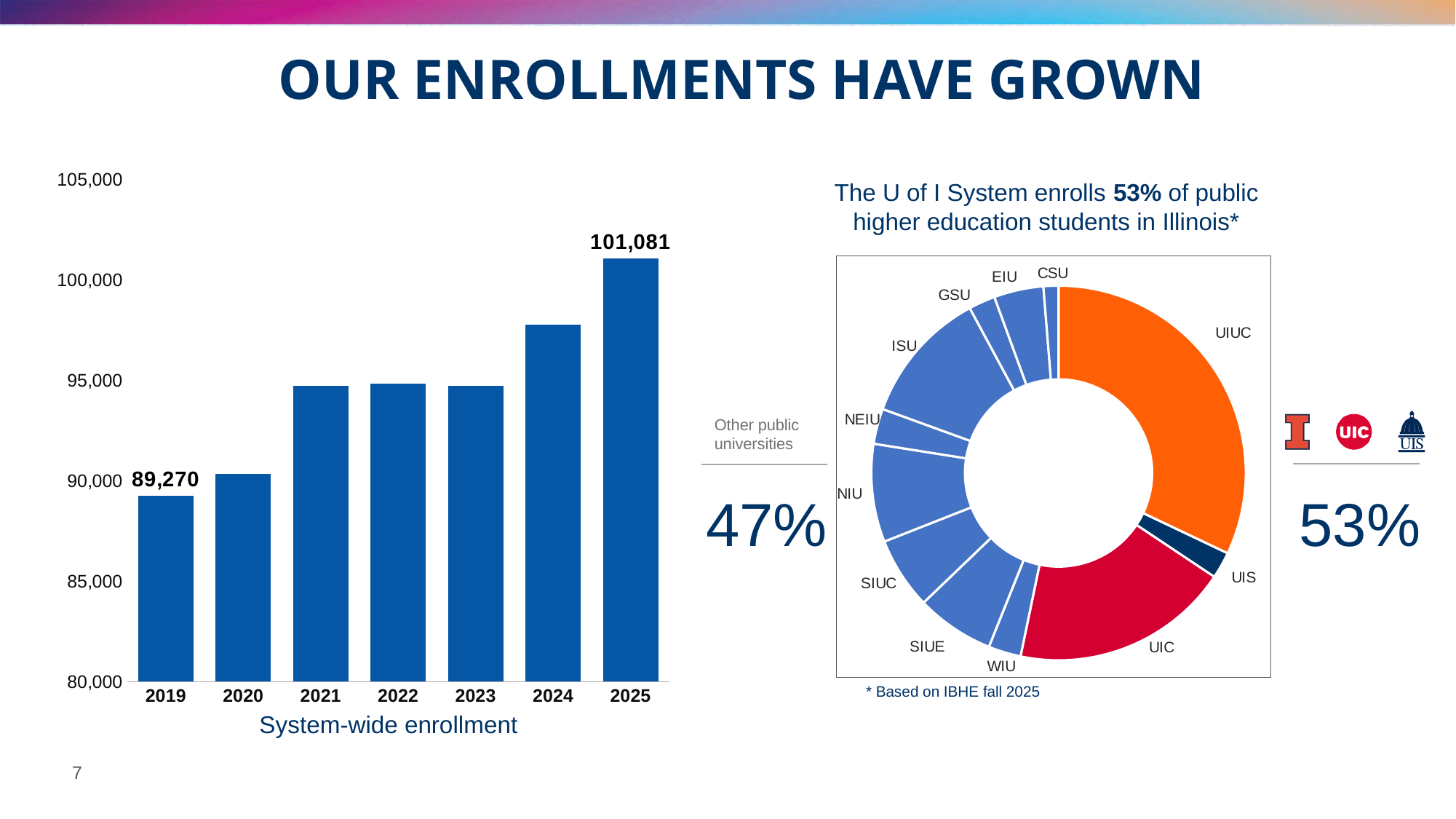
In the System-wide enrollment bar chart, do enrollments generally rise or fall from 2019 to 2025? Rise In the System-wide enrollment bar chart, which year has the lowest enrollment? 2019 In the System-wide enrollment bar chart, what was the enrollment in 2025? 101,081 In the System-wide enrollment bar chart, which year has the highest enrollment? 2025 In the System-wide enrollment bar chart, what was the enrollment in 2019? 89,270 In the System-wide enrollment bar chart, is the value for 2020 greater or less than 95,000? less In the donut chart of public higher education students in Illinois, what share is enrolled by the U of I System? 53% In the donut chart of public higher education students in Illinois, which university has the largest slice? UIUC In the System-wide enrollment bar chart, is the value for 2024 greater or less than 95,000? greater How many years are shown in the System-wide enrollment bar chart? 7 What type of chart is the System-wide enrollment chart? Bar chart In the System-wide enrollment bar chart, by how much did enrollment grow from 2019 to 2025? 11,811